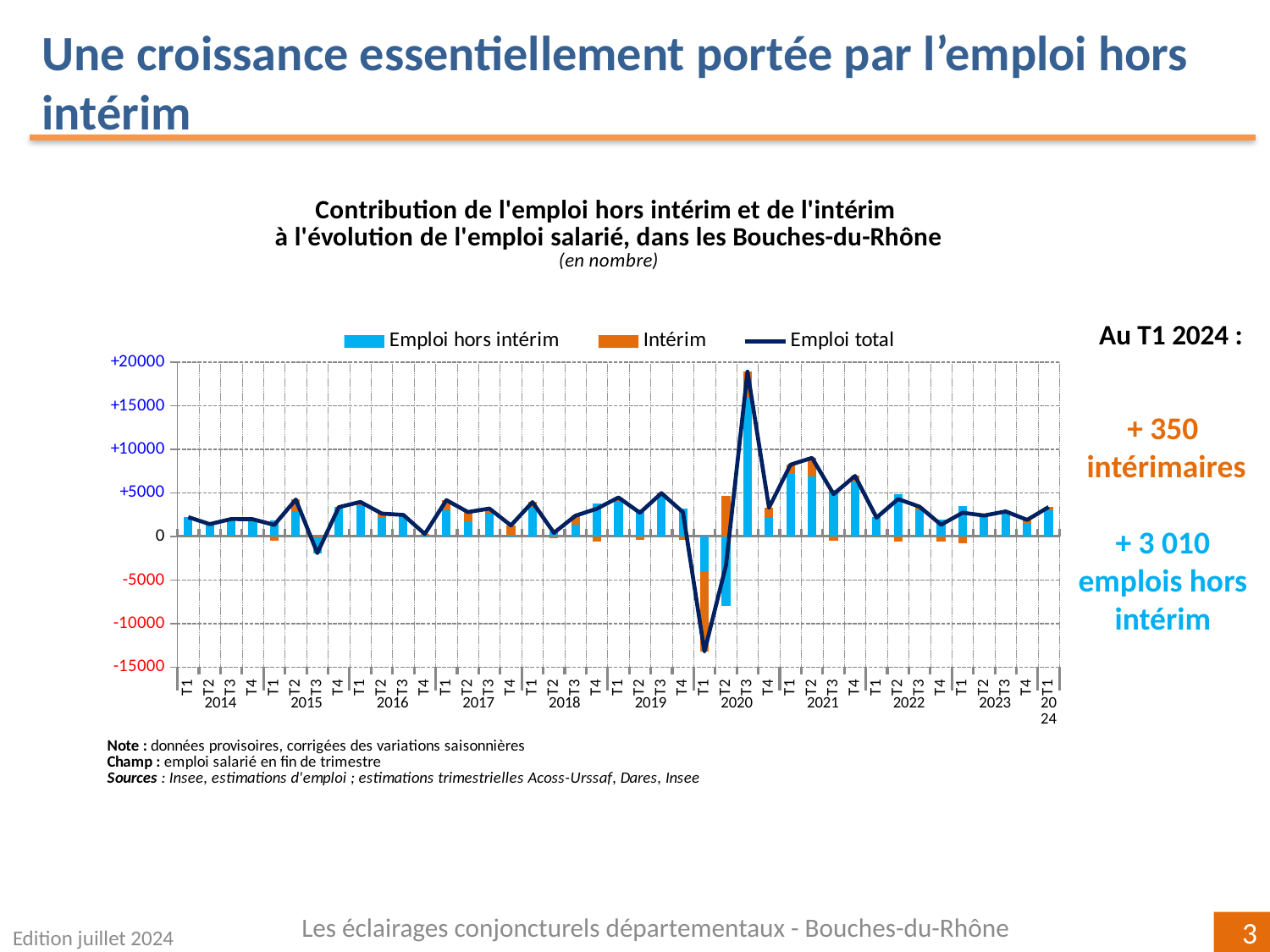
Is the Emploi total value for T2 2021 greater or less than 5000? greater What kind of chart is shown on the slide? A combined bar and line chart According to the text beside the chart, how many intérimaires were added at T1 2024? + 350 Is the Emploi total value for T3 2020 greater or less than 15000? greater Is the Emploi total value for T1 2020 greater or less than -10000? less Which is larger, the Emploi total value for T3 2020 or for T1 2021? T3 2020 What are the three series named in the legend? Emploi hors intérim, Intérim, Emploi total In which quarter does the Emploi total line reach its lowest value? T1 2020 What colour are the Intérim bars? Orange How many series does the legend list? 3 According to the text beside the chart, how many emplois hors intérim were added at T1 2024? + 3 010 In which quarter does the Emploi total line reach its highest value? T3 2020